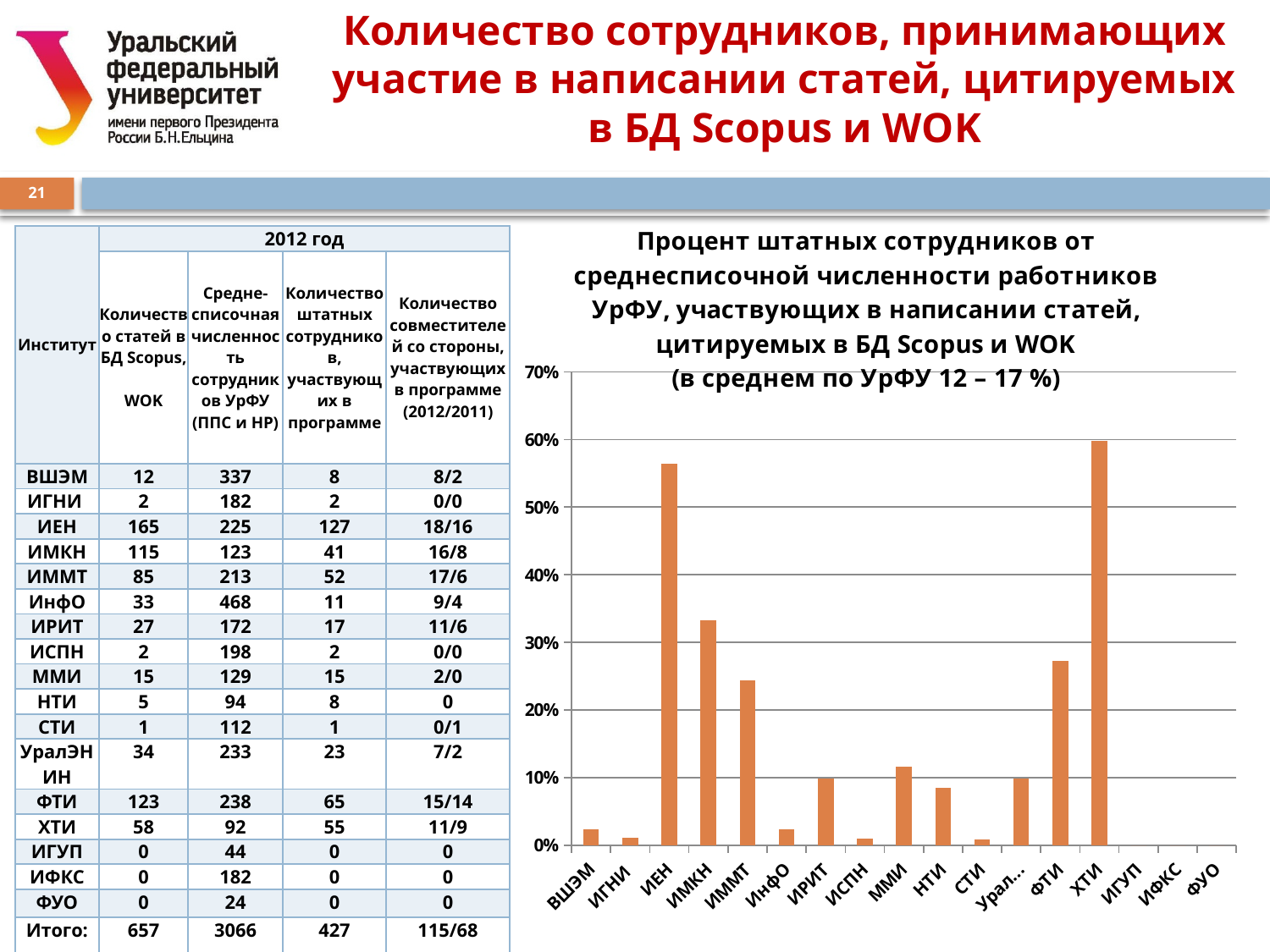
In the bar chart, which institute has the highest percentage? ХТИ What is the highest value shown on the y axis of the bar chart? 70% In the bar chart, is the value for ИнфО greater or less than 10%? less In the bar chart, which is larger, the value for ИЕН or the value for ИМКН? ИЕН In the bar chart, is the value for ИМКН greater or less than 30%? greater How many institutes are listed along the x axis of the bar chart? 17 In the bar chart, is the value for ФТИ greater or less than 20%? greater In the bar chart, which is larger, the value for ФТИ or the value for ИММТ? ФТИ What kind of chart is shown on the right side of the slide? bar chart